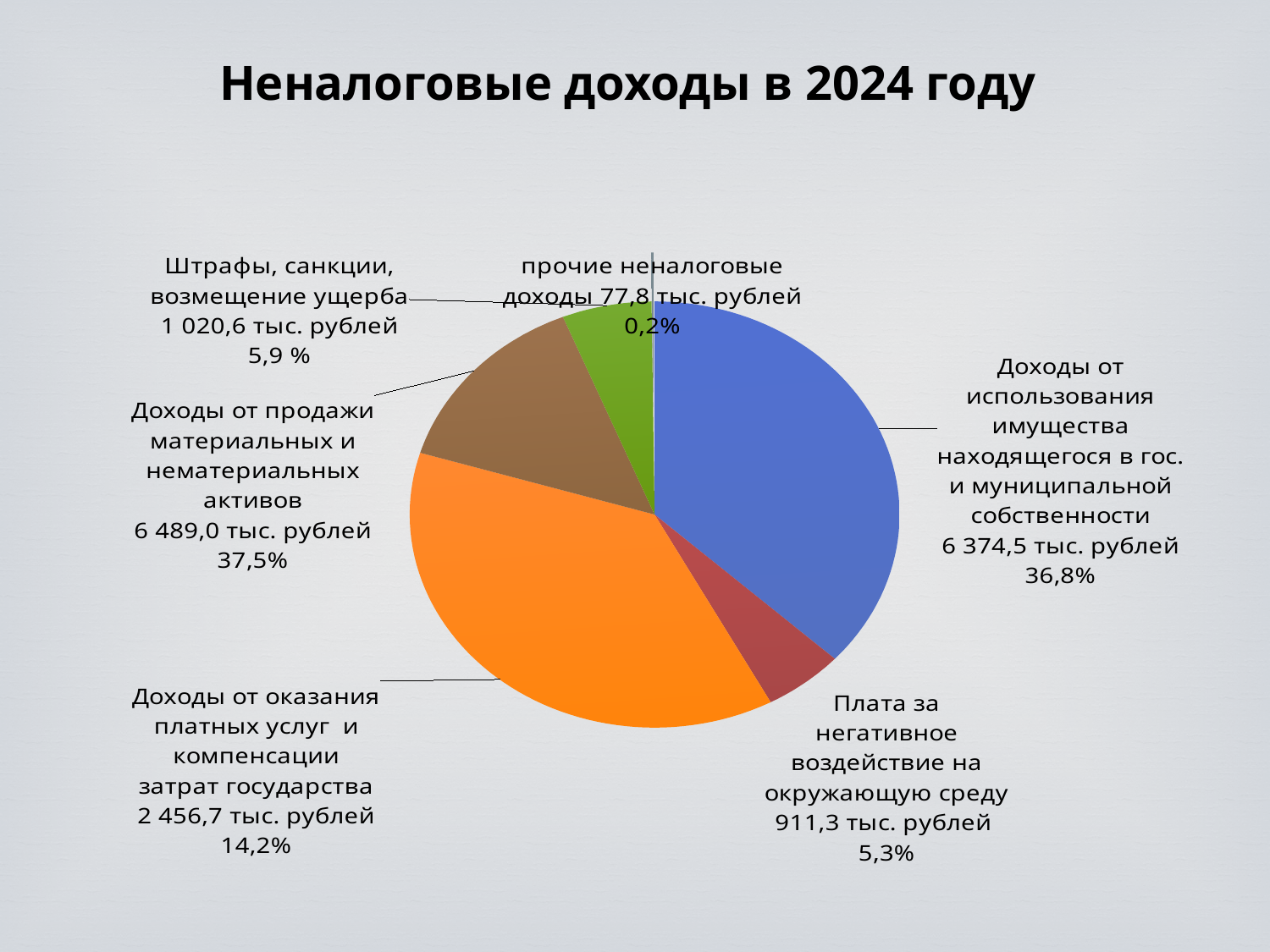
Which category has the smallest share of the pie? прочие неналоговые доходы What is the value for «Плата за негативное воздействие на окружающую среду»? 911,3 тыс. рублей Which is larger: «Штрафы, санкции, возмещение ущерба» or «Плата за негативное воздействие на окружающую среду»? Штрафы, санкции, возмещение ущерба What share of the pie is «Доходы от продажи материальных и нематериальных активов»? 37,5% What is the value for «прочие неналоговые доходы»? 77,8 тыс. рублей What is the difference in value between «Доходы от продажи материальных и нематериальных активов» and «Доходы от использования имущества находящегося в гос. и муниципальной собственности»? 114,5 тыс. рублей What is the value for «Доходы от использования имущества находящегося в гос. и муниципальной собственности»? 6 374,5 тыс. рублей What is the title of the chart? Неналоговые доходы в 2024 году What kind of chart is shown on the slide? Pie chart What share of the pie is «Доходы от оказания платных услуг и компенсации затрат государства»? 14,2% How many categories (slices) does the pie chart have? 6 Which category has the largest share of the pie? Доходы от продажи материальных и нематериальных активов